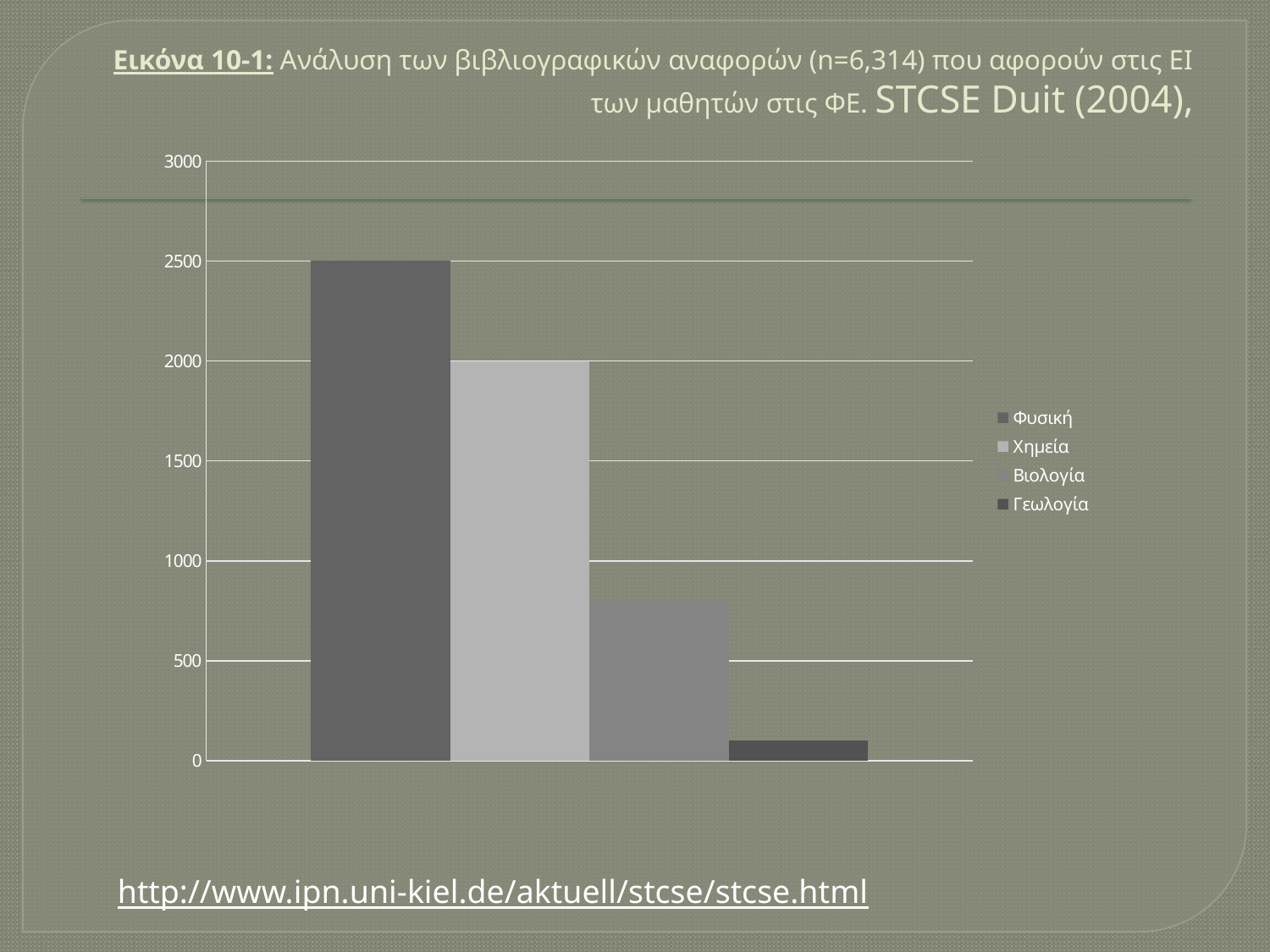
Is the value for Βιολογία greater or less than 1000? less How many series does the legend list? 4 Which is larger, the Χημεία bar or the Βιολογία bar? Χημεία What kind of chart is shown on the slide? bar chart Which series has the highest bar? Φυσική What is the value of the Χημεία bar? 2000 Is the value for Βιολογία greater or less than 500? greater What is the value of the Φυσική bar? 2500 What is the difference between the Φυσική and Χημεία bars? 500 Which series has the lowest bar? Γεωλογία What is the highest value shown on the vertical axis? 3000 Is the value for Γεωλογία greater or less than 500? less